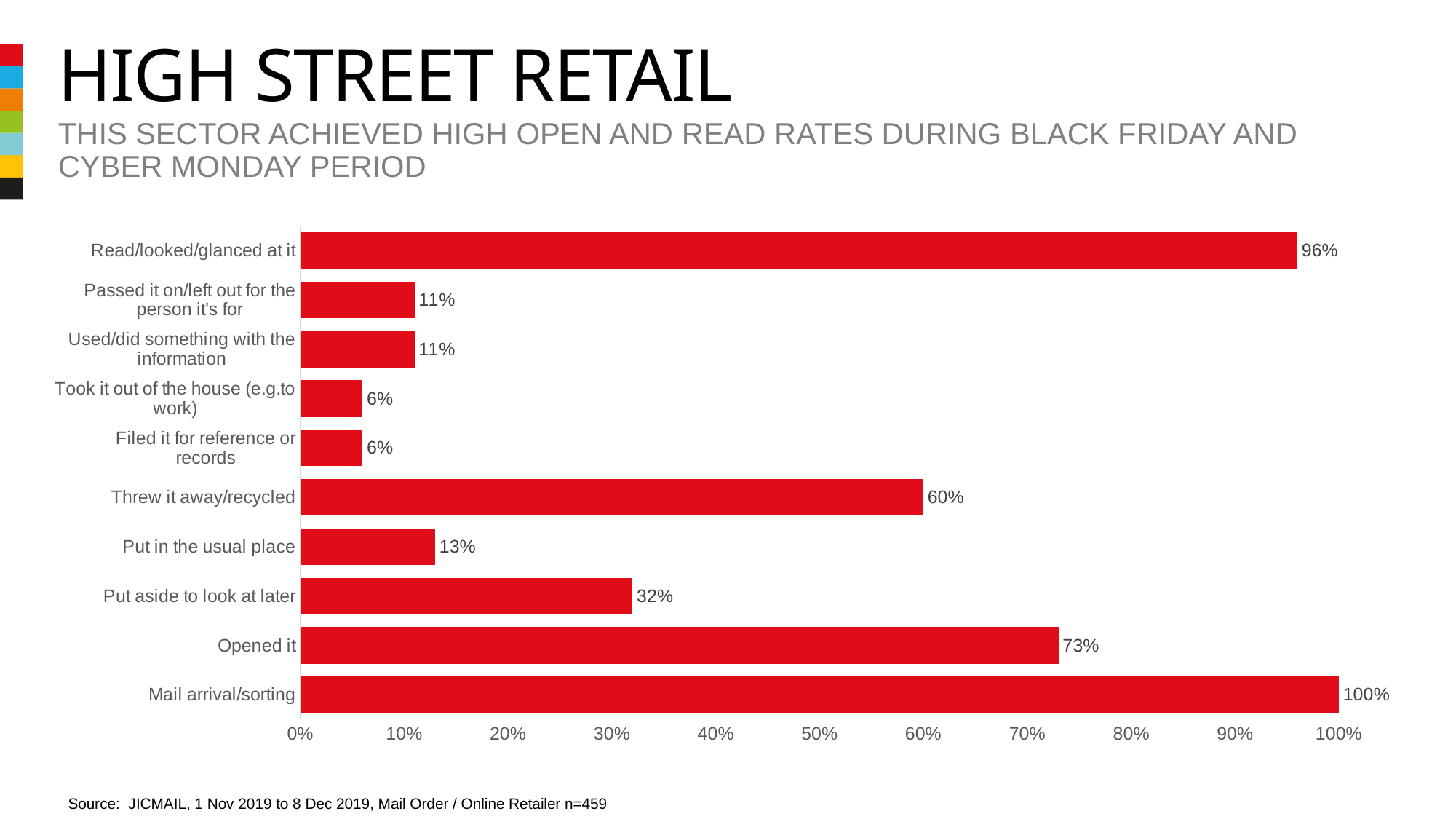
What kind of chart is shown on the slide? Bar chart Which category has the highest value? Mail arrival/sorting What colour are the bars in the chart? Red What is the difference between Threw it away/recycled and Put aside to look at later? 28% What is the value for Put aside to look at later? 32% What is the value for Opened it? 73% What is the value for Mail arrival/sorting? 100% What is the difference between Read/looked/glanced at it and Opened it? 23% Which is larger, Put in the usual place or Put aside to look at later? Put aside to look at later Is the value for Opened it greater or less than 70%? greater What is the value for Threw it away/recycled? 60% How many categories are shown in the chart? 10